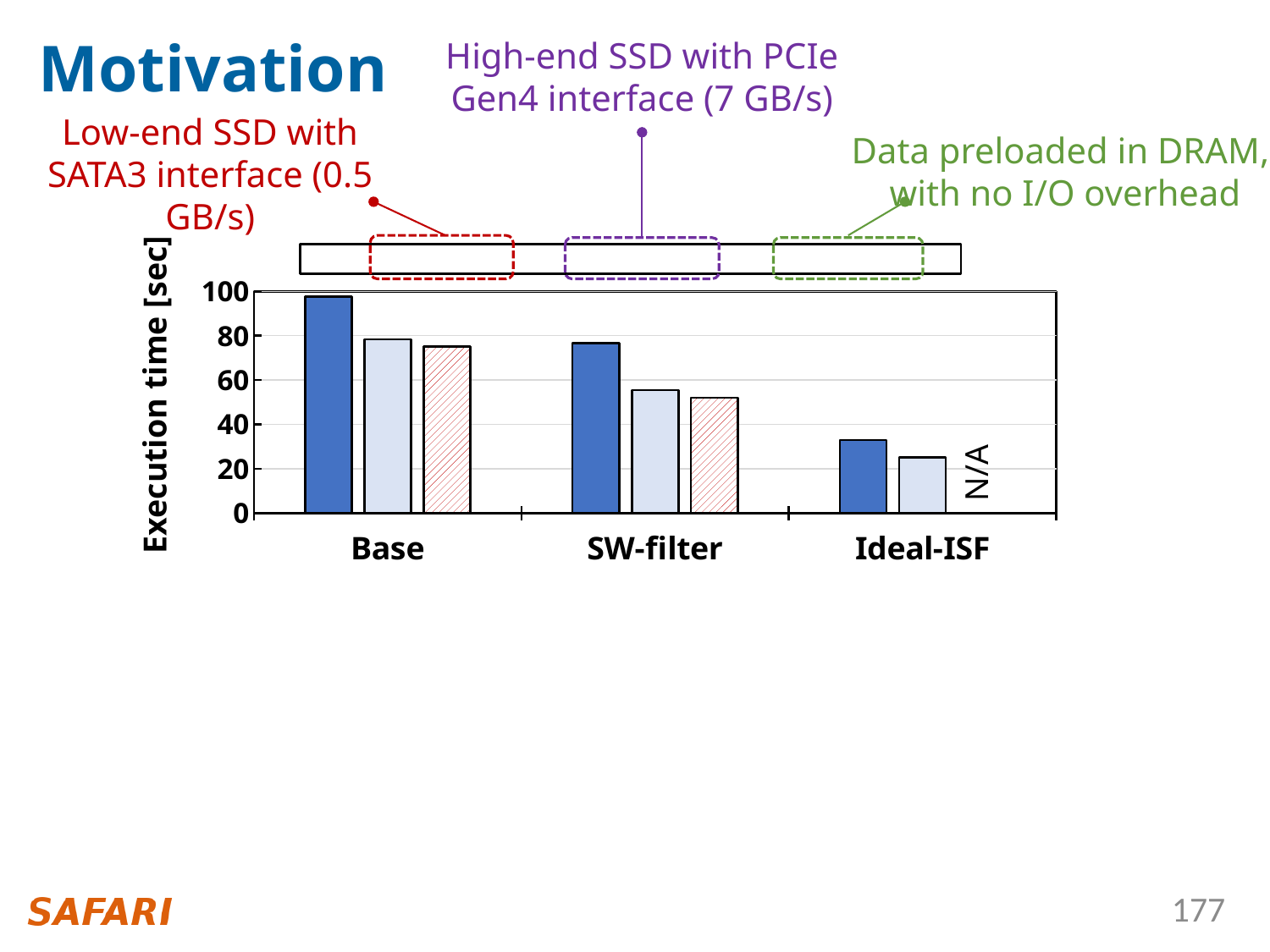
Which category has the shortest dark blue bar? Ideal-ISF How many categories are shown on the x axis of the chart? 3 Which category has the tallest dark blue bar? Base Do the dark blue bars rise or fall from Base to Ideal-ISF? fall What kind of chart is shown on the slide? bar chart For which category is the third (hatched) bar marked N/A? Ideal-ISF Is the value of the light blue bar for Base greater or less than 60? greater Is the value of the red hatched bar for SW-filter greater or less than 60? less Which is larger, the dark blue bar for Base or the dark blue bar for SW-filter? Base What is the label of the y axis of the chart? Execution time [sec] Is the value of the dark blue bar for Base greater or less than 80? greater